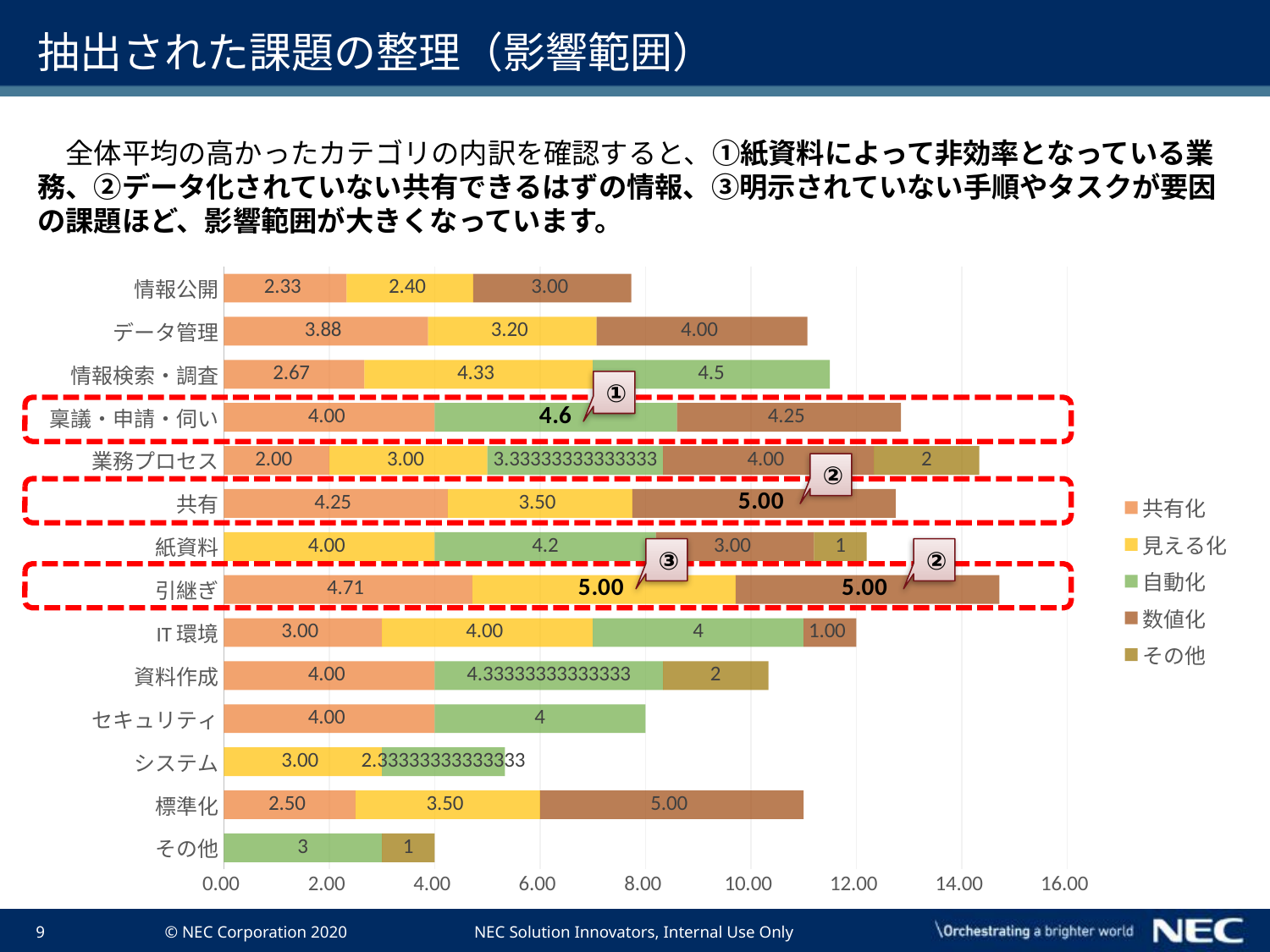
For データ管理, what is the difference between the 数値化 value and the 見える化 value? 0.80 What is the total of the stacked bar for 共有? 12.75 What is the 自動化 value for 稟議・申請・伺い? 4.6 Which category has the shortest stacked bar overall? その他 Which category has the longest stacked bar overall? 引継ぎ What is the 共有化 value for 引継ぎ? 4.71 What kind of chart is shown on the slide? Stacked bar chart Is the total of the stacked bar for IT環境 greater or less than 10.00? greater How many categories are shown on the vertical axis of the chart? 14 What is the total of the stacked bar for 標準化? 11.00 What is the 数値化 value for 共有? 5.00 How many series does the legend list? 5